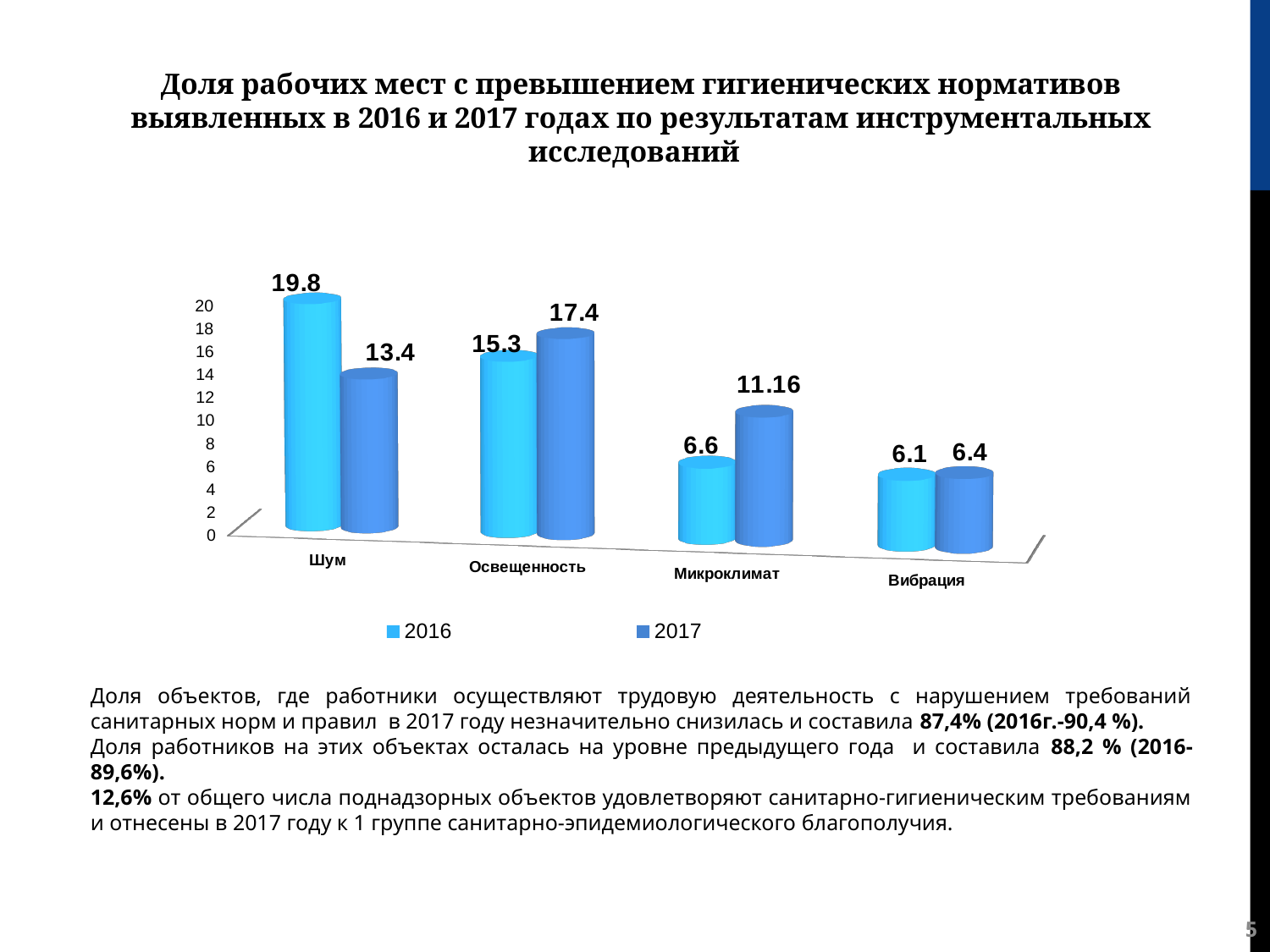
What is the difference between the 2016 and 2017 values for Шум? 6.4 What is the difference between the 2017 and 2016 values for Микроклимат? 4.56 What are the two series named in the legend? 2016 and 2017 What is the value for Микроклимат in 2017? 11.16 Which category has the highest value in the 2016 series? Шум Which is larger for Освещенность: the 2016 value or the 2017 value? 2017 What is the value for Вибрация in 2016? 6.1 Which category has the lowest value in the 2017 series? Вибрация What is the value for Шум in 2016? 19.8 What kind of chart is shown on the slide? Bar chart How many series does the legend list? 2 How many categories are shown on the x axis? 4